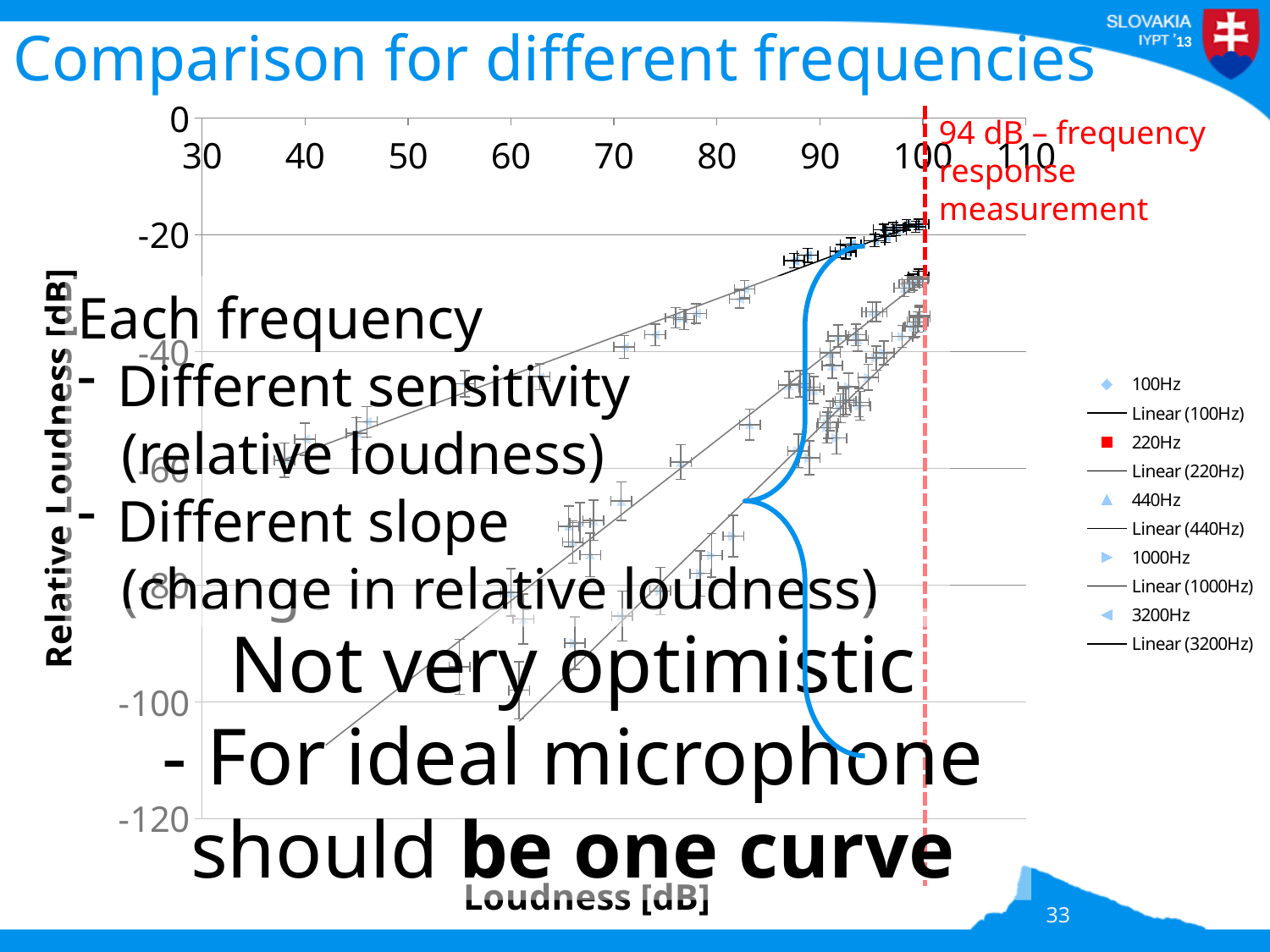
How many entries does the chart's legend list? 10 Do the plotted relative loudness values rise or fall as loudness increases along the x axis? rise How many different frequencies are plotted as data series in the chart? 5 What is the title of the chart's y axis? Relative Loudness [dB] What is the title of the chart's x axis? Loudness [dB] What kind of chart is shown on the slide? scatter chart